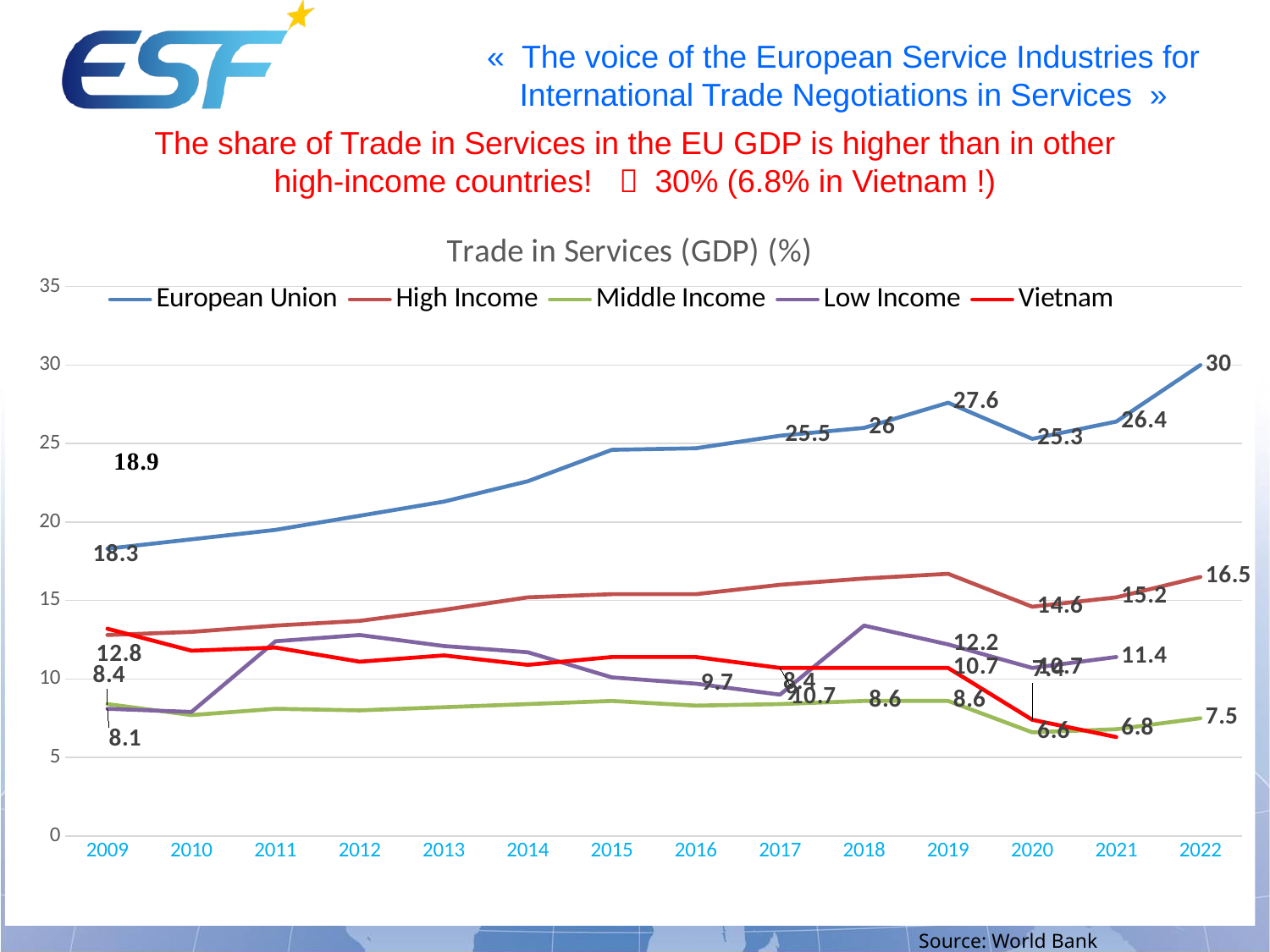
What is the value for the European Union in 2019? 27.6 What is the value for Low Income in 2021? 11.4 What is the difference between the European Union and High Income values in 2022? 13.5 How many series does the legend list? 5 How many years are shown on the x axis? 14 What is the value for the European Union in 2022? 30 What is the value for High Income in 2022? 16.5 Which series has the highest value in 2022? European Union Does the European Union line generally rise or fall from 2009 to 2022? Rise What is the value for Middle Income in 2022? 7.5 Is the value for Middle Income in 2015 greater or less than 10? less What type of chart is shown on the slide? Line chart